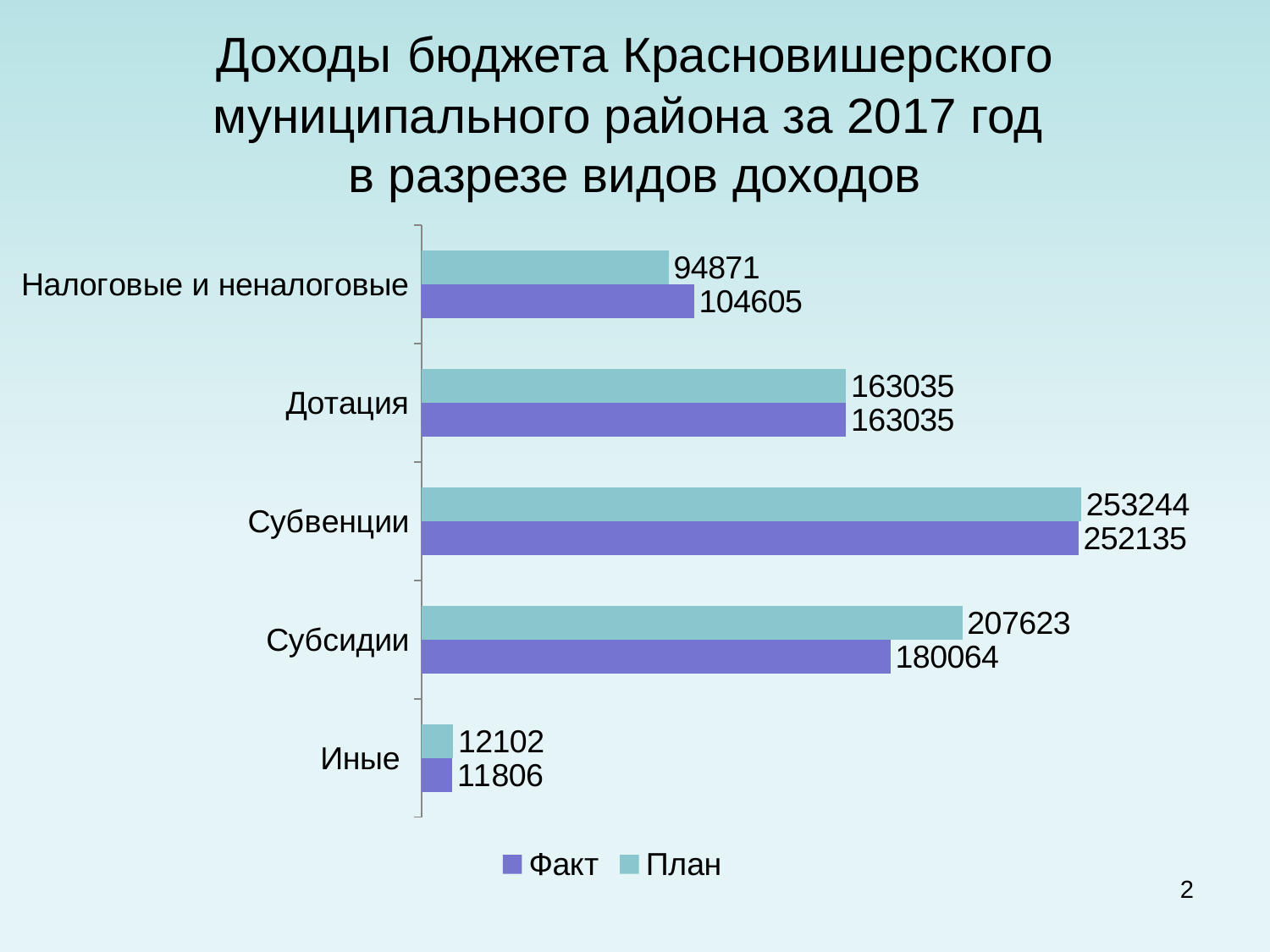
What is the Факт value for Налоговые и неналоговые? 104605 How many series does the legend list? 2 How many categories are shown on the chart? 5 Which category has the lowest План value? Иные What is the План value for Субсидии? 207623 What is the difference between the Факт and План values for Налоговые и неналоговые? 9734 What is the План value for Субвенции? 253244 What kind of chart is shown on the slide? Bar chart What is the Факт value for Иные? 11806 What is the difference between the План and Факт values for Субсидии? 27559 Which is larger for Субсидии, the План value or the Факт value? План Which category has the highest Факт value? Субвенции